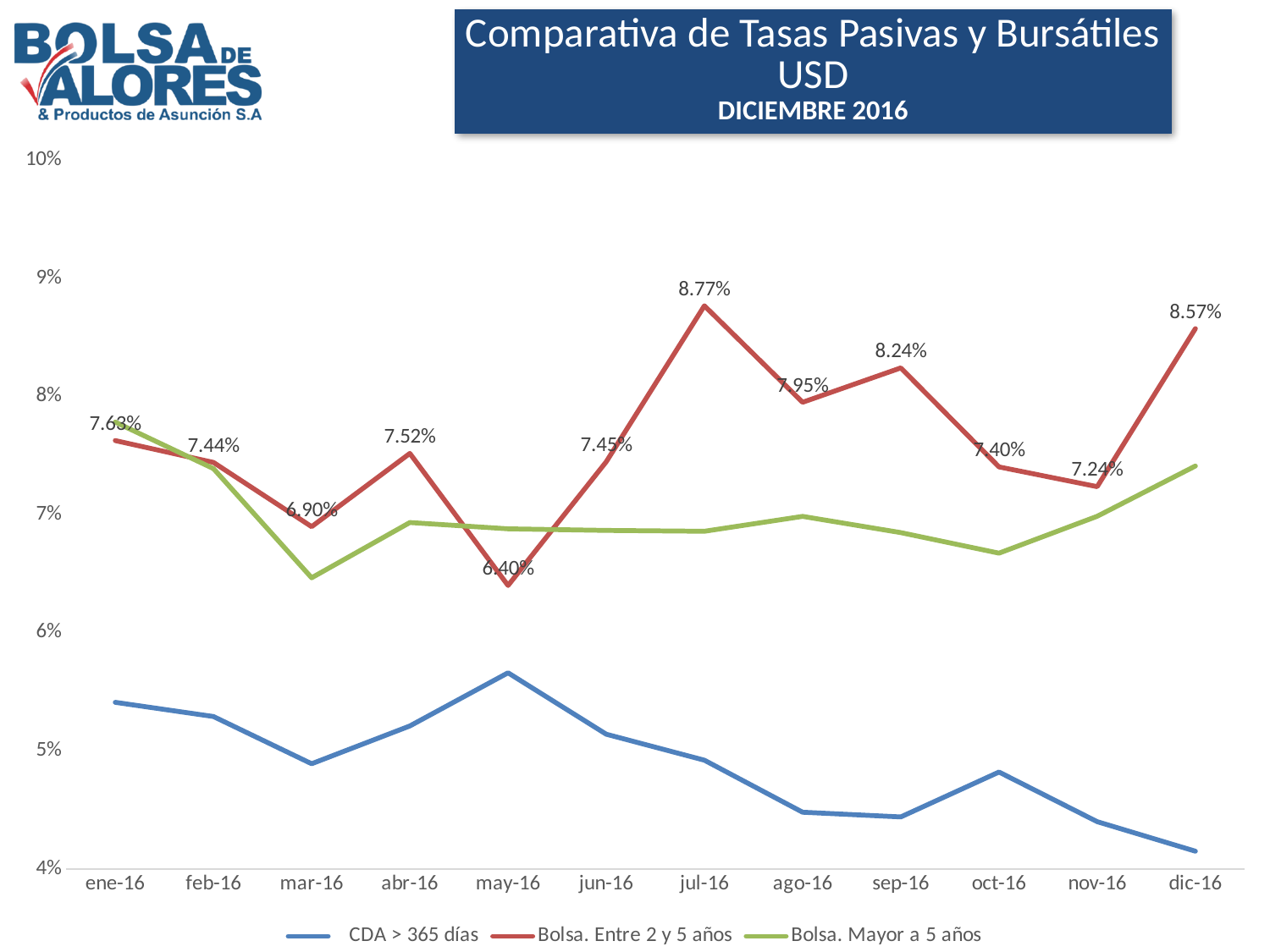
What is the value of the Bolsa. Entre 2 y 5 años series in may-16? 6.40% What is the value of the Bolsa. Entre 2 y 5 años series in dic-16? 8.57% How many series does the legend list? 3 What is the value of the Bolsa. Entre 2 y 5 años series in jul-16? 8.77% Does the CDA > 365 días series rise or fall from oct-16 to dic-16? fall What is the difference between the Bolsa. Entre 2 y 5 años values in jul-16 and sep-16? 0.53% How many months are shown on the x axis? 12 What kind of chart is shown on the slide? line chart Is the value of the CDA > 365 días series in dic-16 greater or less than 5%? less For the Bolsa. Entre 2 y 5 años series, which month has the larger value, ago-16 or sep-16? sep-16 In which month does the Bolsa. Entre 2 y 5 años series reach its lowest value? may-16 In which month does the Bolsa. Entre 2 y 5 años series reach its highest value? jul-16